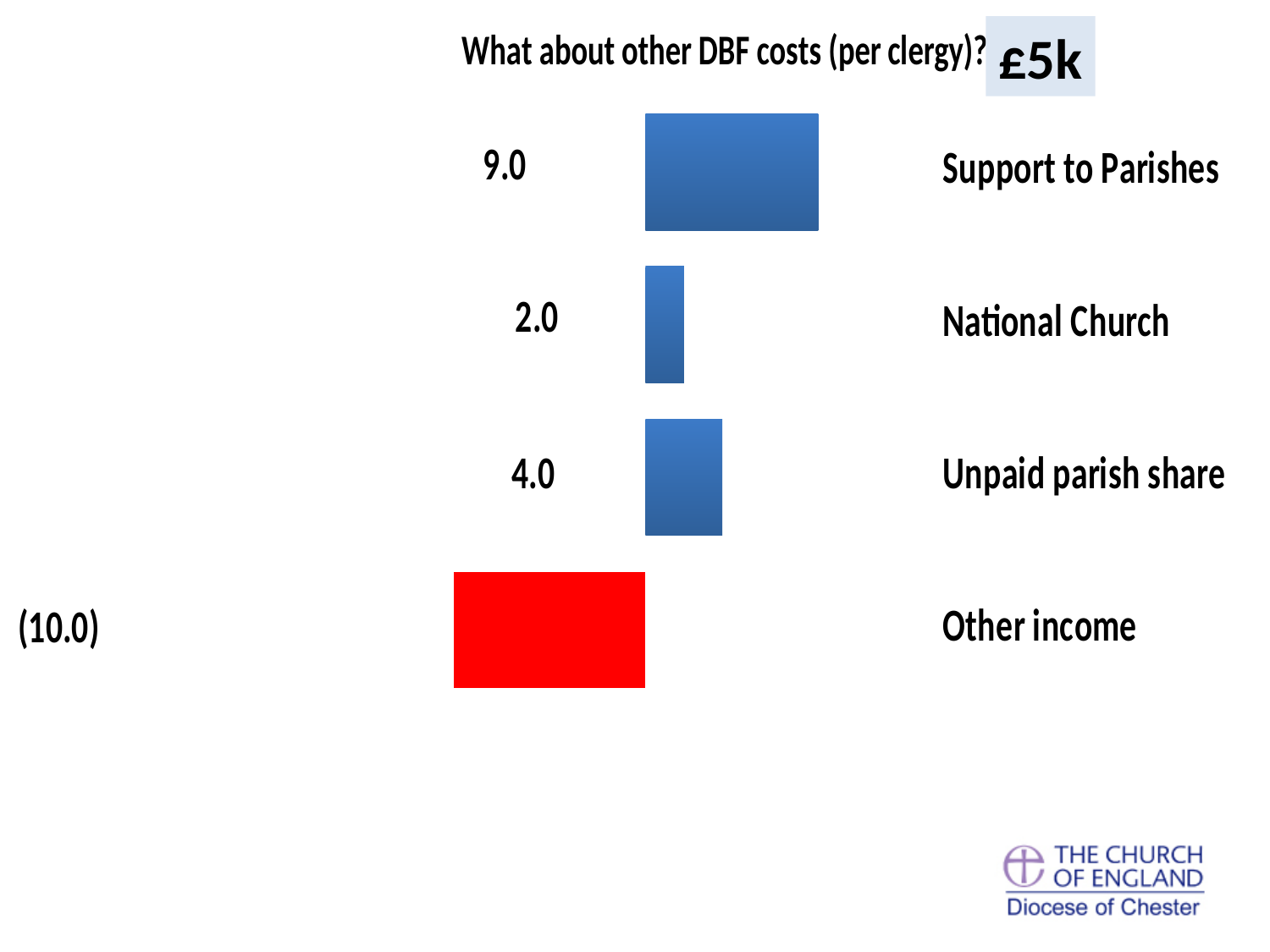
Which category's bar is coloured red? Other income What is the value for Support to Parishes? 9.0 Which is larger, the value for National Church or the value for Unpaid parish share? Unpaid parish share What is the value shown for Other income? (10.0) How many categories are shown in the chart? 4 Which category has the highest positive value? Support to Parishes What is the value for National Church? 2.0 What kind of chart is shown on the slide? Bar chart What is the difference between the values for Support to Parishes and Unpaid parish share? 5.0 Which category has the lowest value? Other income What is the value for Unpaid parish share? 4.0 What is the title of the chart? What about other DBF costs (per clergy)?